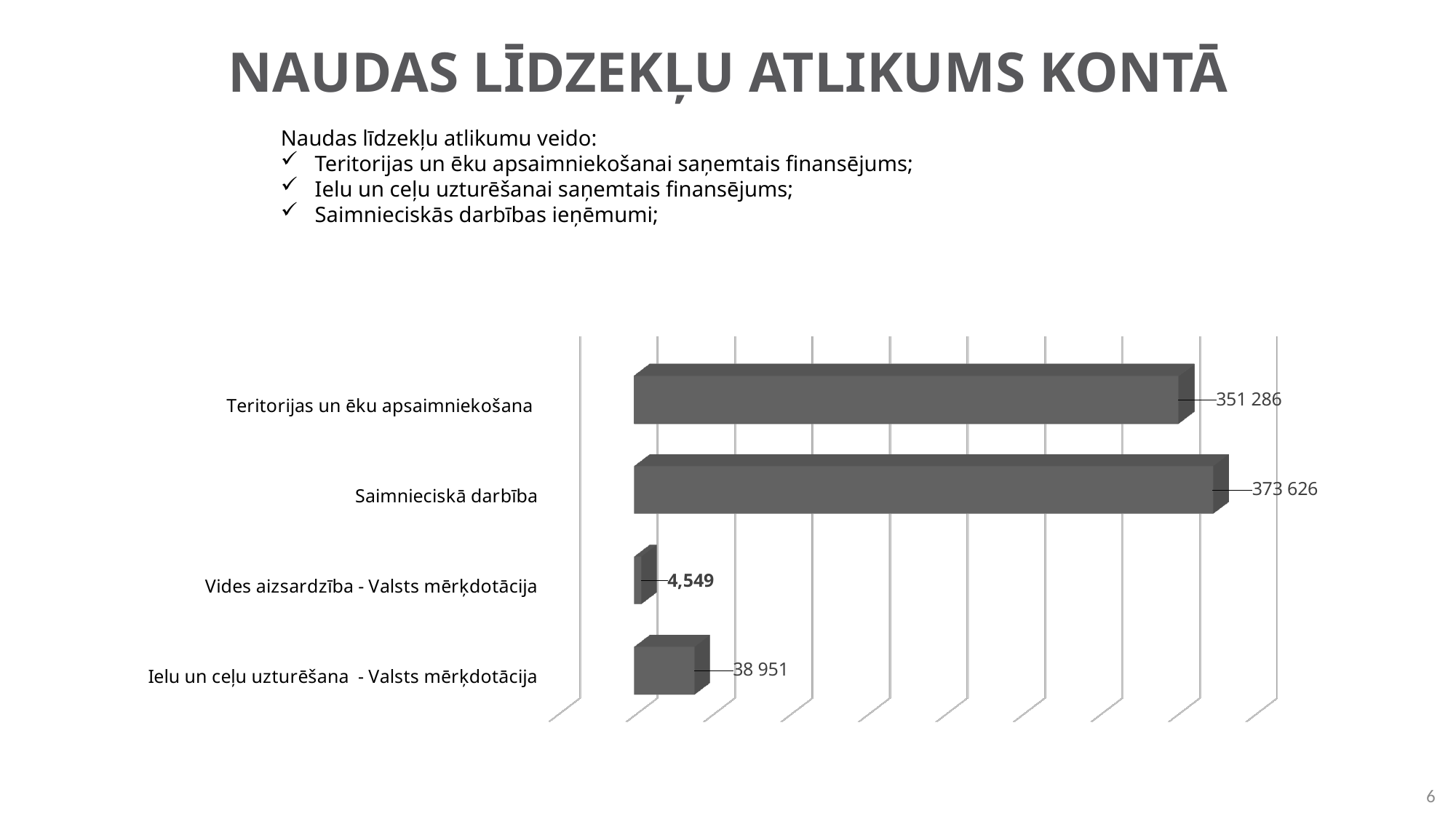
What is the difference between the values for Ielu un ceļu uzturēšana - Valsts mērķdotācija and Vides aizsardzība - Valsts mērķdotācija? 34 402 What is the value for Vides aizsardzība - Valsts mērķdotācija? 4,549 What is the value for Saimnieciskā darbība? 373 626 Which category has the lowest value? Vides aizsardzība - Valsts mērķdotācija What is the title of the slide containing the chart? NAUDAS LĪDZEKĻU ATLIKUMS KONTĀ What kind of chart is shown on the slide? Bar chart What is the difference between the values for Saimnieciskā darbība and Teritorijas un ēku apsaimniekošana? 22 340 Which is larger: the value for Ielu un ceļu uzturēšana - Valsts mērķdotācija or the value for Vides aizsardzība - Valsts mērķdotācija? Ielu un ceļu uzturēšana - Valsts mērķdotācija What is the value for Ielu un ceļu uzturēšana - Valsts mērķdotācija? 38 951 What is the value for Teritorijas un ēku apsaimniekošana? 351 286 How many categories are shown in the chart? 4 Which category has the highest value? Saimnieciskā darbība